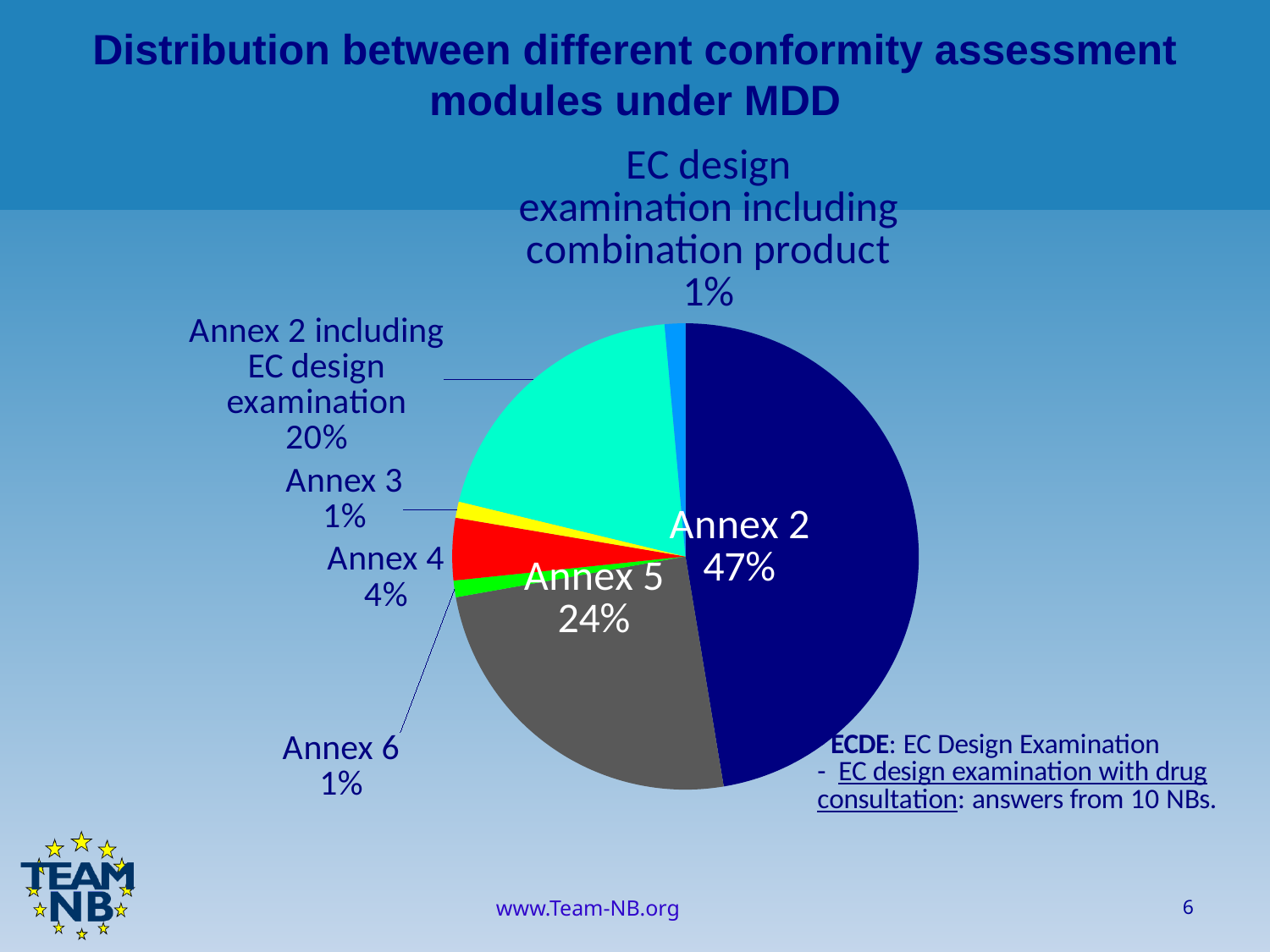
What is the difference in percentage points between Annex 2 and Annex 5? 23 Which category has the largest slice of the pie? Annex 2 Which is larger, the share for Annex 5 or the share for Annex 2 including EC design examination? Annex 5 What is the title of the chart on the slide? Distribution between different conformity assessment modules under MDD What percentage is shown for Annex 4? 4% What share of the pie does Annex 2 represent? 47% What is the difference in percentage points between Annex 4 and Annex 3? 3 What percentage is shown for Annex 2 including EC design examination? 20% What type of chart is shown on the slide? Pie chart What percentage is shown for EC design examination including combination product? 1% What share of the pie does Annex 5 represent? 24% How many slices does the pie chart have? 7